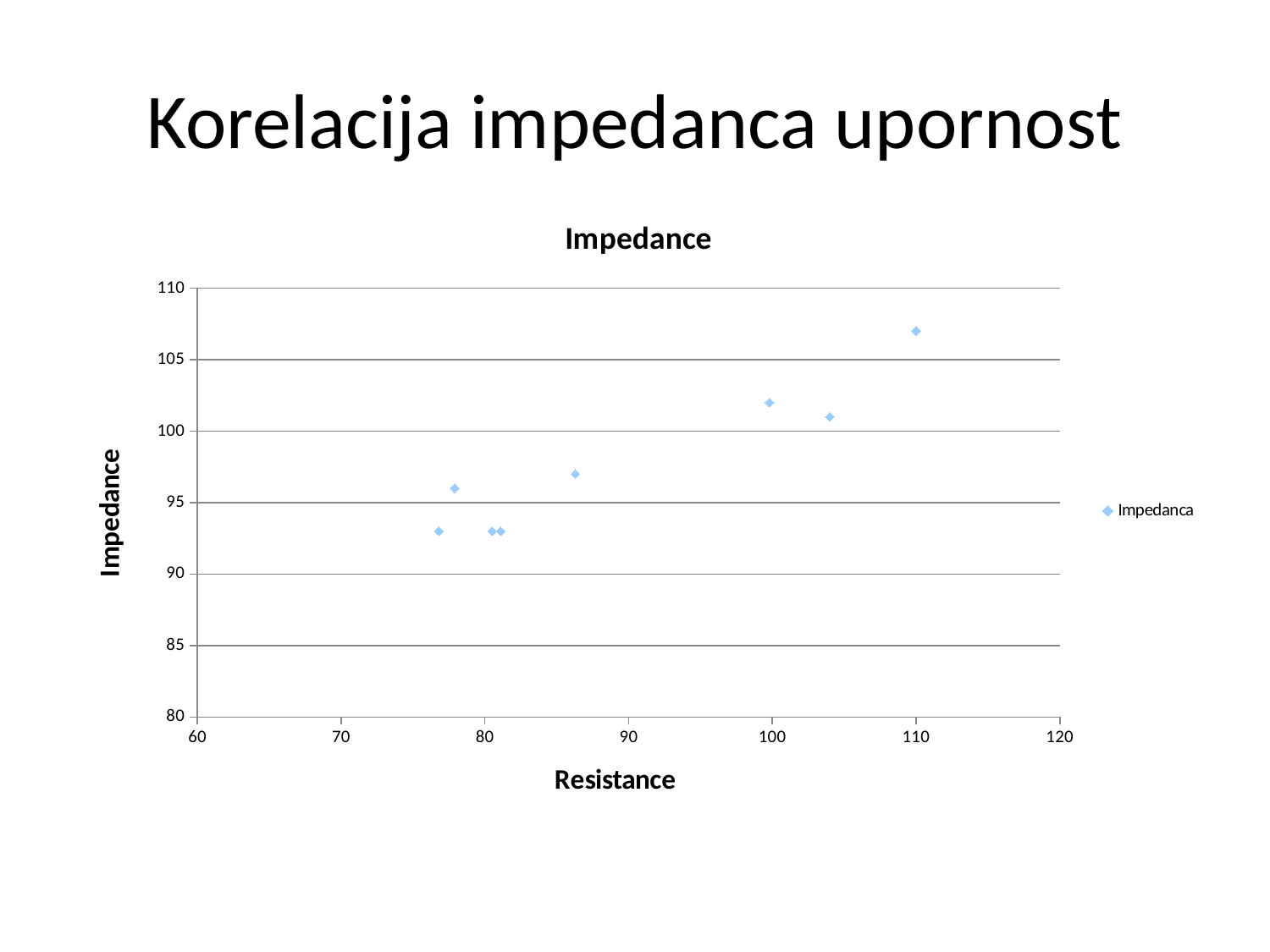
Does impedance generally rise or fall as resistance increases along the x axis? Rise What is the title of the chart? Impedance Which has the higher impedance: the point at a resistance of about 100 or the point at a resistance of about 104? The point at about 100 Is the impedance of the point at a resistance of about 100 greater or less than 100? greater Does the point with the highest impedance also have the highest resistance? Yes What is the label of the x axis? Resistance Is the impedance of the point with the highest resistance greater or less than 105? greater How many data points are plotted on the chart? 8 What is the name of the series in the legend? Impedanca What kind of chart is shown on the slide? Scatter chart Is the impedance of the leftmost point (lowest resistance) greater or less than 95? less How many series does the legend list? 1